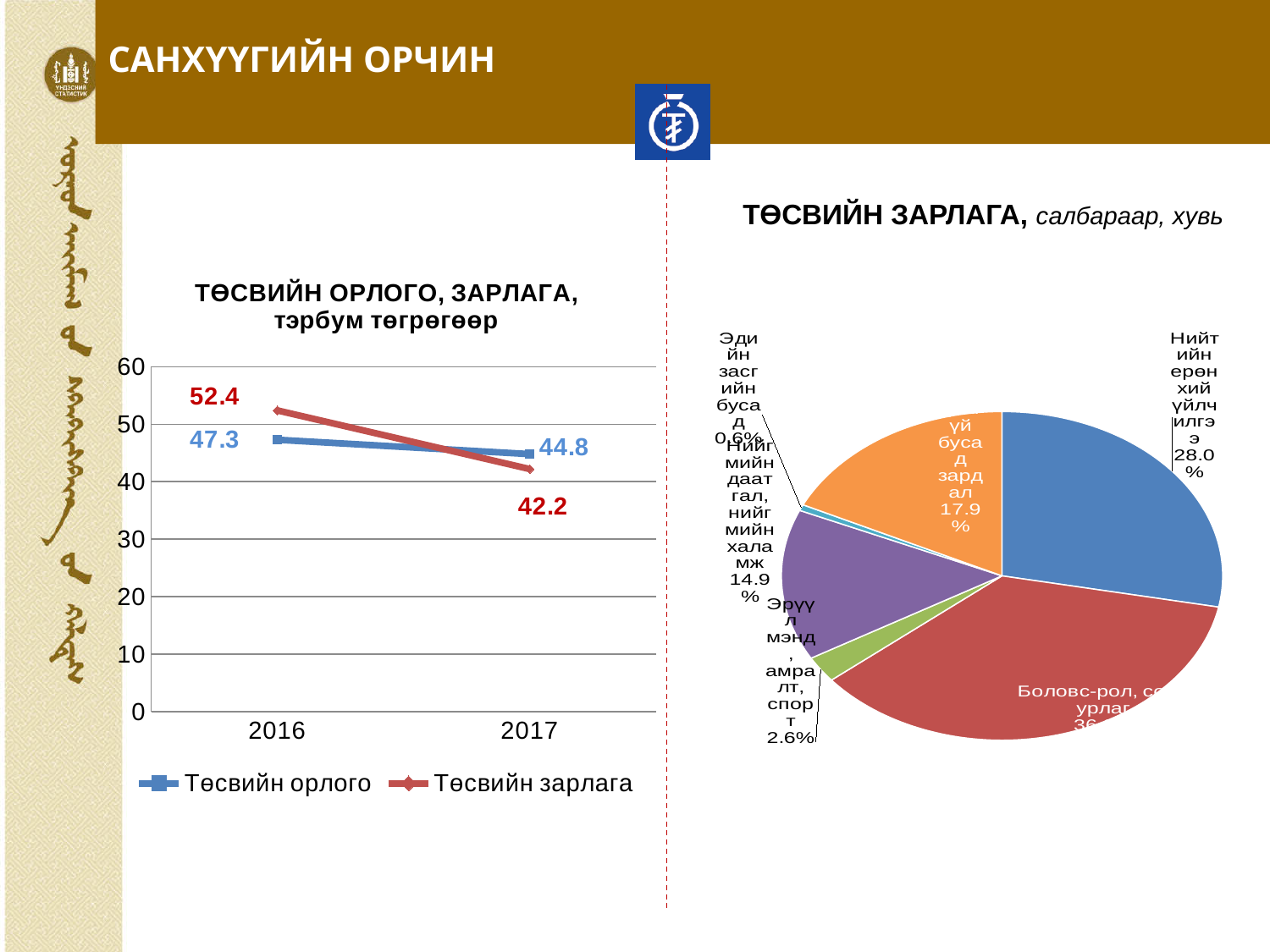
In the line chart 'ТӨСВИЙН ОРЛОГО, ЗАРЛАГА', what is the value of Төсвийн зарлага in 2017? 42.2 In the line chart 'ТӨСВИЙН ОРЛОГО, ЗАРЛАГА', does Төсвийн зарлага rise or fall from 2016 to 2017? fall In the line chart 'ТӨСВИЙН ОРЛОГО, ЗАРЛАГА', which series has the higher value in 2017? Төсвийн орлого In the pie chart 'ТӨСВИЙН ЗАРЛАГА, салбараар, хувь', what share does Нийгмийн даатгал, нийгмийн халамж have? 14.9% What kind of chart is the chart titled 'ТӨСВИЙН ОРЛОГО, ЗАРЛАГА, тэрбум төгрөгөөр'? line chart In the line chart 'ТӨСВИЙН ОРЛОГО, ЗАРЛАГА', which series has the higher value in 2016? Төсвийн зарлага In the line chart 'ТӨСВИЙН ОРЛОГО, ЗАРЛАГА', what is the difference between Төсвийн орлого in 2016 and in 2017? 2.5 In the pie chart 'ТӨСВИЙН ЗАРЛАГА, салбараар, хувь', which slice is the smallest? Эдийн засгийн бусад In the line chart 'ТӨСВИЙН ОРЛОГО, ЗАРЛАГА', by how much did Төсвийн зарлага fall from 2016 to 2017? 10.2 In the line chart 'ТӨСВИЙН ОРЛОГО, ЗАРЛАГА', what is the value of Төсвийн орлого in 2016? 47.3 In the pie chart 'ТӨСВИЙН ЗАРЛАГА, салбараар, хувь', what share does Нийтийн ерөнхий үйлчилгээ have? 28.0% How many series does the legend of the line chart 'ТӨСВИЙН ОРЛОГО, ЗАРЛАГА' list? 2